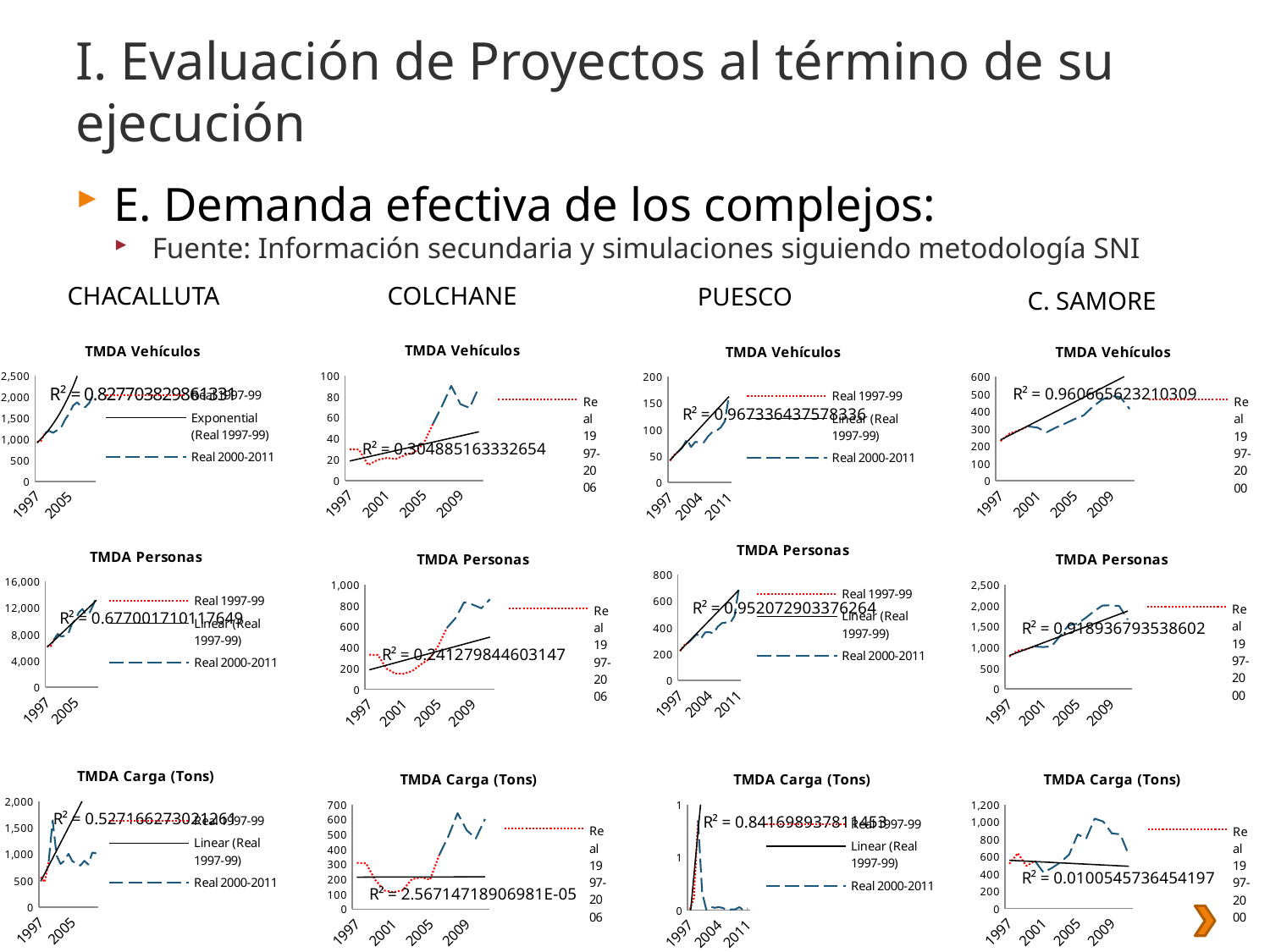
What R² value is printed on the C. SAMORE TMDA Vehículos chart? 0.960665623210309 In the C. SAMORE TMDA Vehículos chart, is the value at 1997 greater or less than 300? less What R² value is printed on the PUESCO TMDA Personas chart? 0.952072903376264 How many entries does the legend of the CHACALLUTA TMDA Vehículos chart list? 3 What R² value is printed on the C. SAMORE TMDA Personas chart? 0.918936793538602 Which chart shows a larger R² value: the COLCHANE TMDA Vehículos chart or the C. SAMORE TMDA Vehículos chart? C. SAMORE TMDA Vehículos What R² value is printed on the COLCHANE TMDA Personas chart? 0.241279844603147 What kind of chart is the CHACALLUTA TMDA Vehículos chart? line chart What R² value is printed on the C. SAMORE TMDA Carga (Tons) chart? 0.0100545736454197 What R² value is printed on the COLCHANE TMDA Vehículos chart? 0.304885163332654 In the C. SAMORE TMDA Personas chart, do the plotted values overall rise or fall from 1997 to 2011? rise